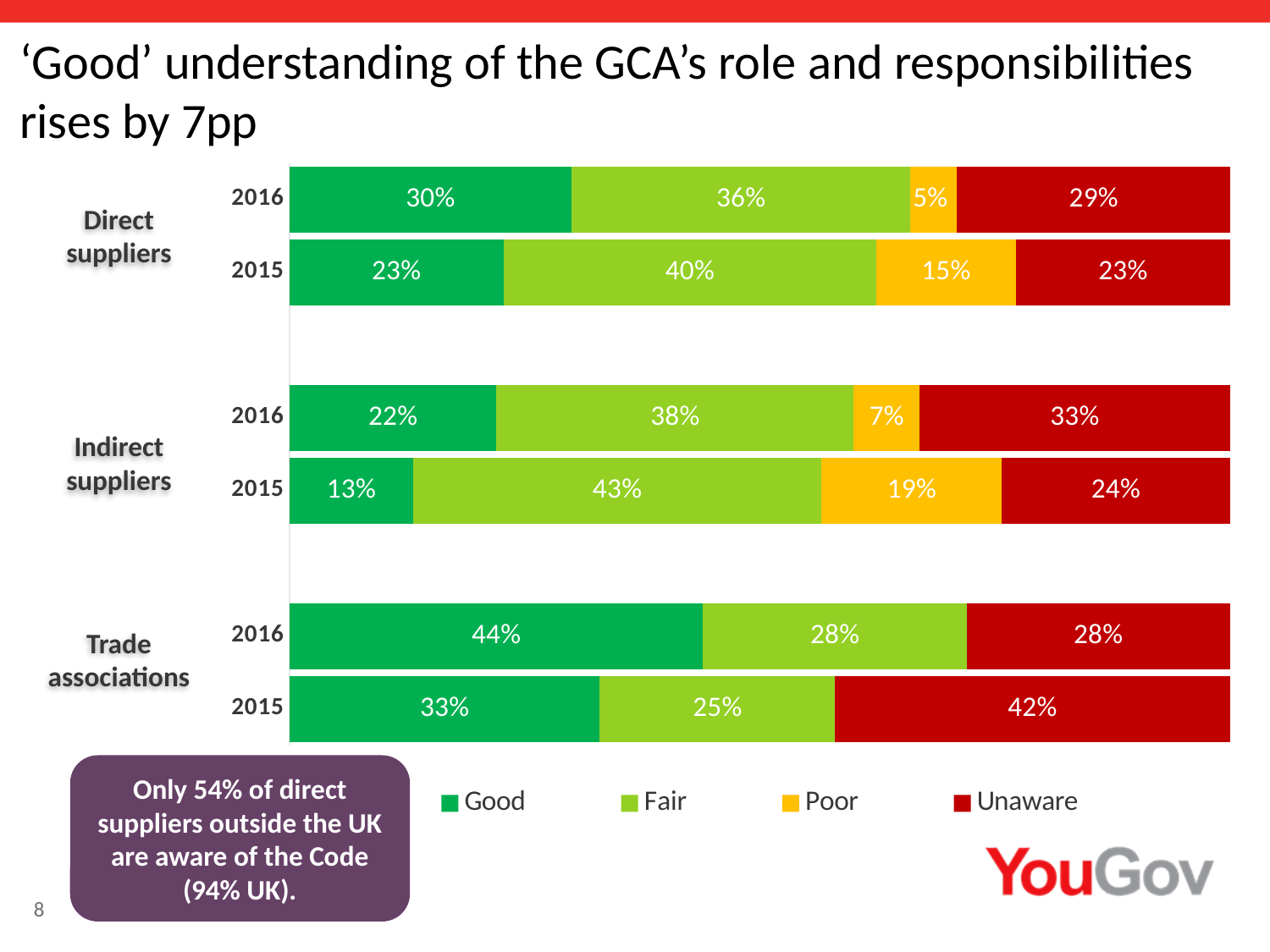
What kind of chart is shown on the slide? Stacked bar chart Which group had the lowest 'Good' percentage in 2015? Indirect suppliers Did the 'Poor' share for direct suppliers rise or fall from 2015 to 2016? Fall Which colour represents the 'Unaware' series in the chart? Red By how many percentage points did the 'Good' share for direct suppliers change from 2015 to 2016? 7 What is the 'Poor' value for indirect suppliers in 2016? 7% What percentage of indirect suppliers were 'Unaware' in 2015? 24% How many series does the legend list? 4 Which group had the highest 'Good' percentage in 2016? Trade associations What percentage of trade associations rated their understanding as 'Fair' in 2016? 28% Which is larger: the 'Unaware' share for trade associations in 2015 or in 2016? 2015 What percentage of direct suppliers had a 'Good' understanding in 2016? 30%